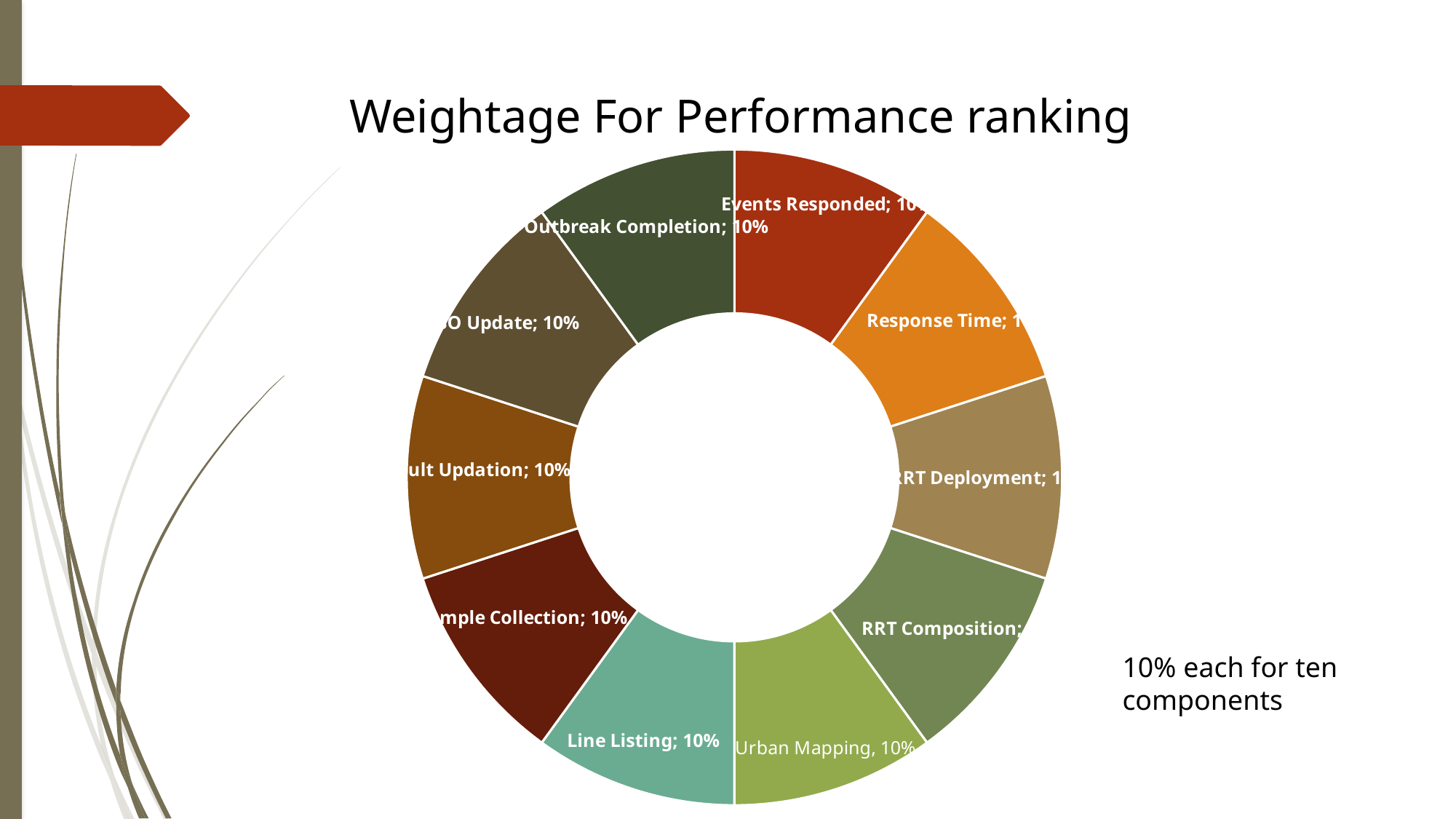
What share of the chart does the Response Time slice represent? 10% Is the weightage for Line Listing larger than, smaller than, or equal to the weightage for Urban Mapping? Equal What is the weightage for Line Listing? 10% According to the text beside the chart, what weightage does each of the ten components receive? 10% each What kind of chart is shown on the slide? Doughnut (pie) chart What is the difference between the weightage for Events Responded and the weightage for Outbreak Completion? 0% What is the title of the chart? Weightage For Performance ranking How many components (slices) does the chart show? 10 What is the weightage for Events Responded? 10% What is the weightage for Urban Mapping? 10% What share of the chart does the RRT Deployment slice represent? 10% What is the weightage for Outbreak Completion? 10%